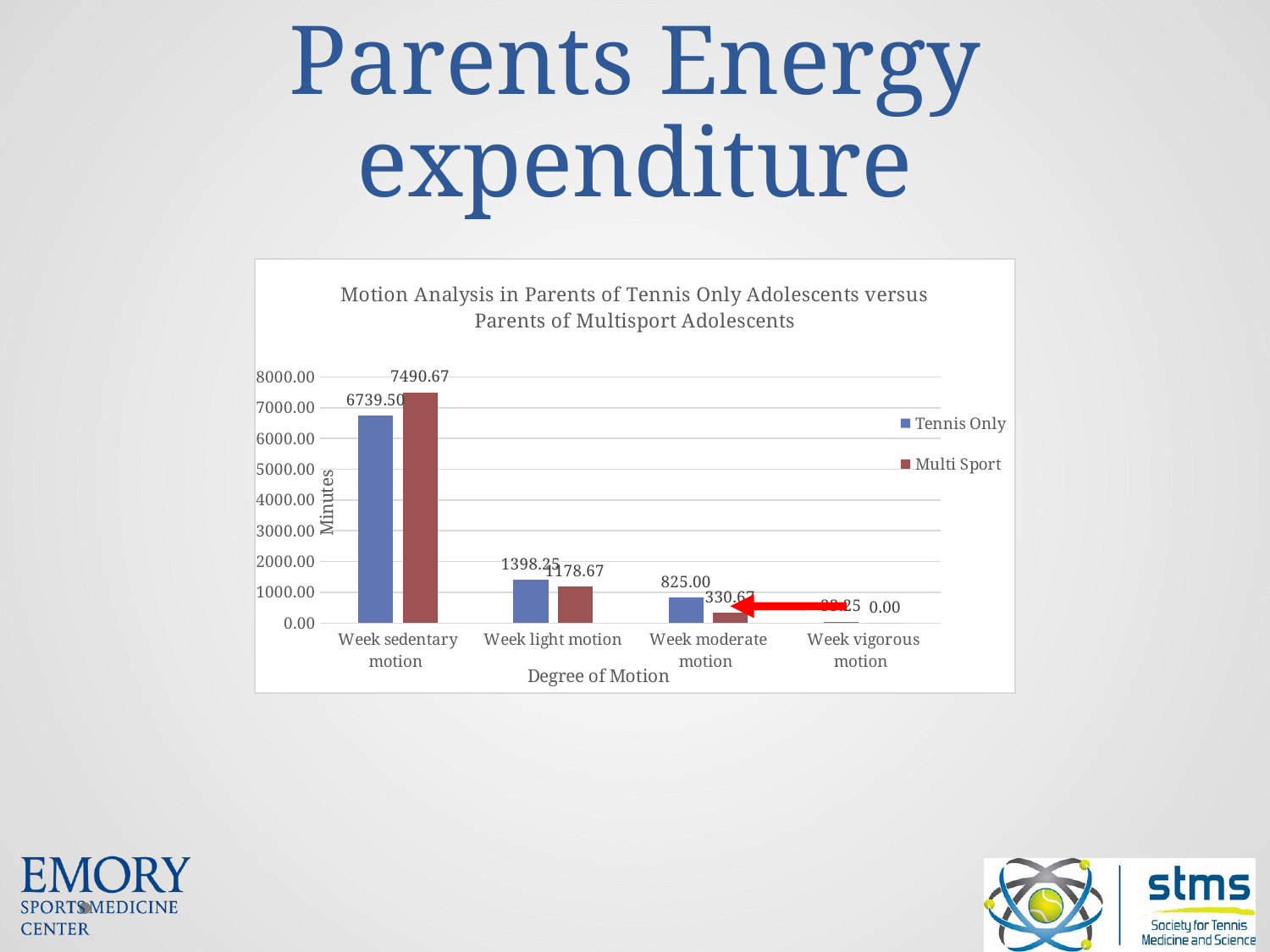
What is the Multi Sport value for Week sedentary motion? 7490.67 For Week sedentary motion, how much larger is the Multi Sport value than the Tennis Only value? 751.17 What is the Tennis Only value for Week sedentary motion? 6739.50 Which degree of motion has the highest Multi Sport value? Week sedentary motion What is the Multi Sport value for Week light motion? 1178.67 What is the title of the vertical axis? Minutes What is the Tennis Only value for Week light motion? 1398.25 How many series does the legend list? 2 What is the Tennis Only value for Week moderate motion? 825.00 What is the Multi Sport value for Week vigorous motion? 0.00 For Week light motion, which series has the larger value, Tennis Only or Multi Sport? Tennis Only Is the Multi Sport value for Week moderate motion greater or less than 1000.00? less